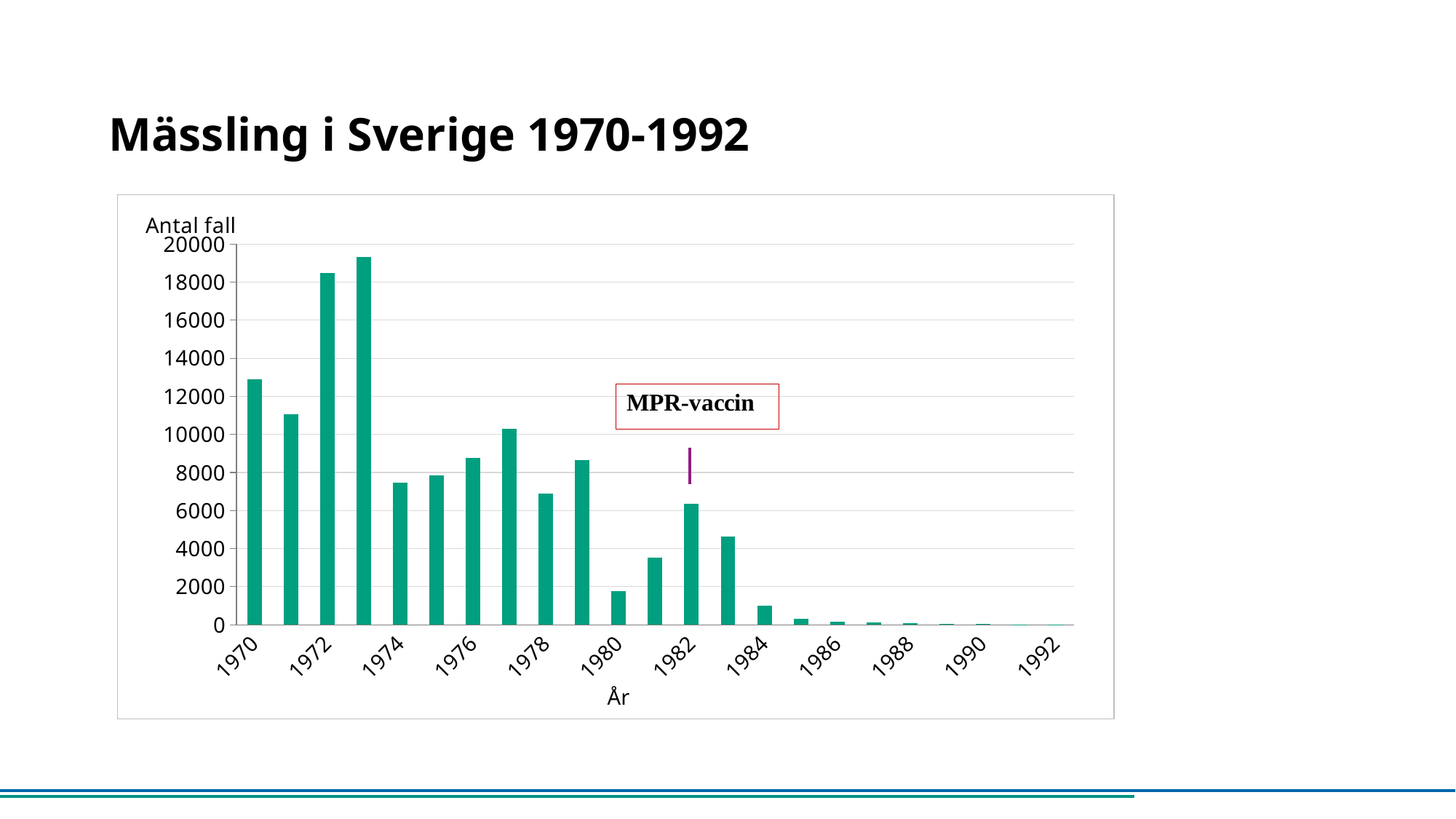
Is the value for 1982 greater or less than 6000? greater Is the value for 1972 greater or less than 18000? greater How many bars (years) are plotted in the chart? 23 Which year has the larger value, 1970 or 1972? 1972 Is the value for 1980 greater or less than 2000? less What kind of chart is shown on the slide? bar chart What label is shown on the vertical axis of the chart? Antal fall Which year has the larger value, 1980 or 1982? 1982 What is the title of the chart on the slide? Mässling i Sverige 1970-1992 Overall, do the values rise or fall from 1970 to 1992? fall